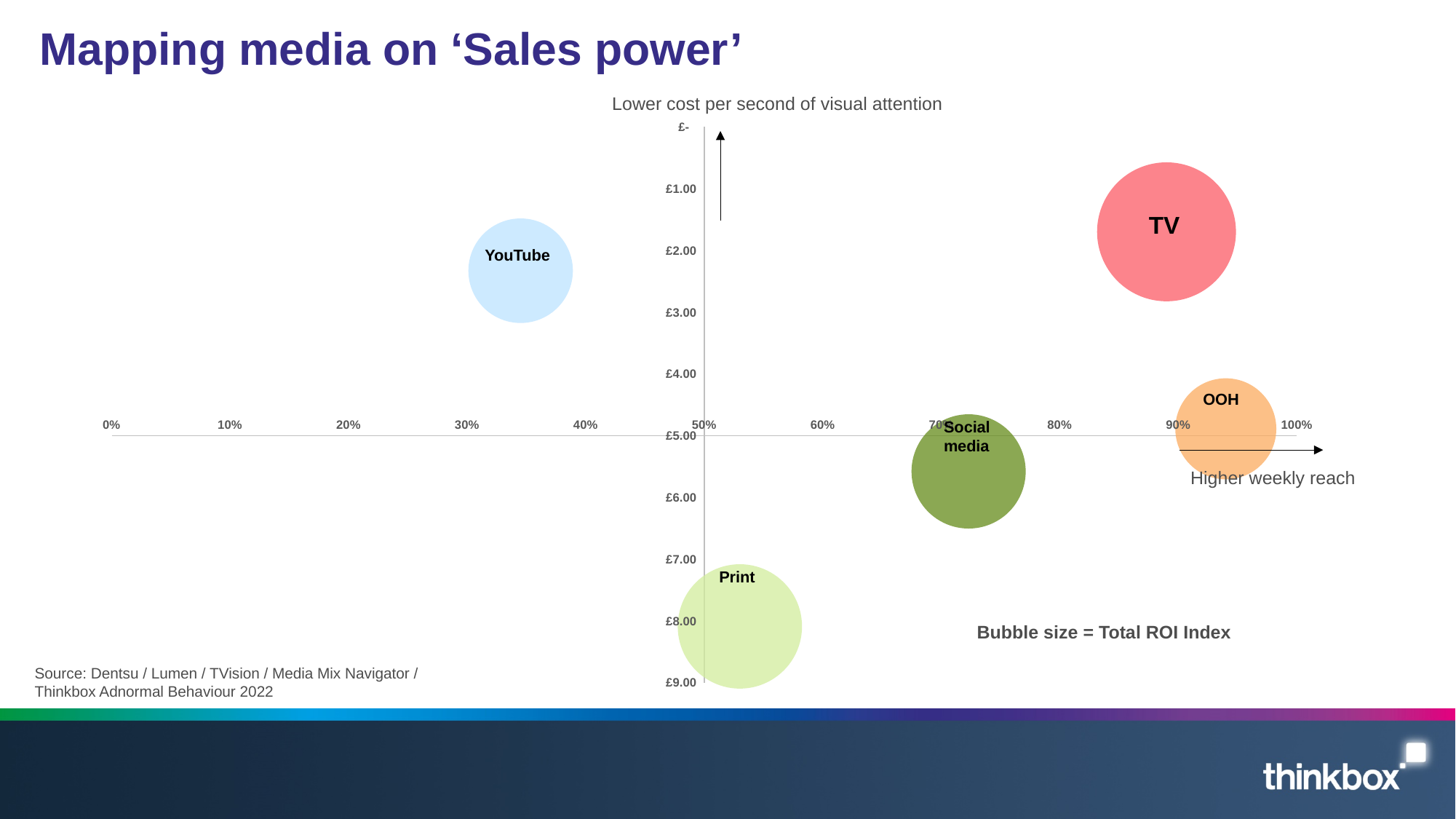
How many media bubbles are plotted on the chart? 5 What does the bubble size represent on the chart? Total ROI Index What kind of chart is shown on the slide? Bubble chart Is the weekly reach for TV greater or less than 80%? greater Is the cost per second of visual attention for Print greater or less than £7.00? greater Which medium is represented by the largest bubble? TV Which medium has the highest weekly reach on the chart? OOH Which medium has the lowest weekly reach on the chart? YouTube Is the weekly reach for YouTube greater or less than 40%? less Which medium has the highest cost per second of visual attention? Print Which has the larger weekly reach, TV or YouTube? TV Which medium has the lowest cost per second of visual attention? TV